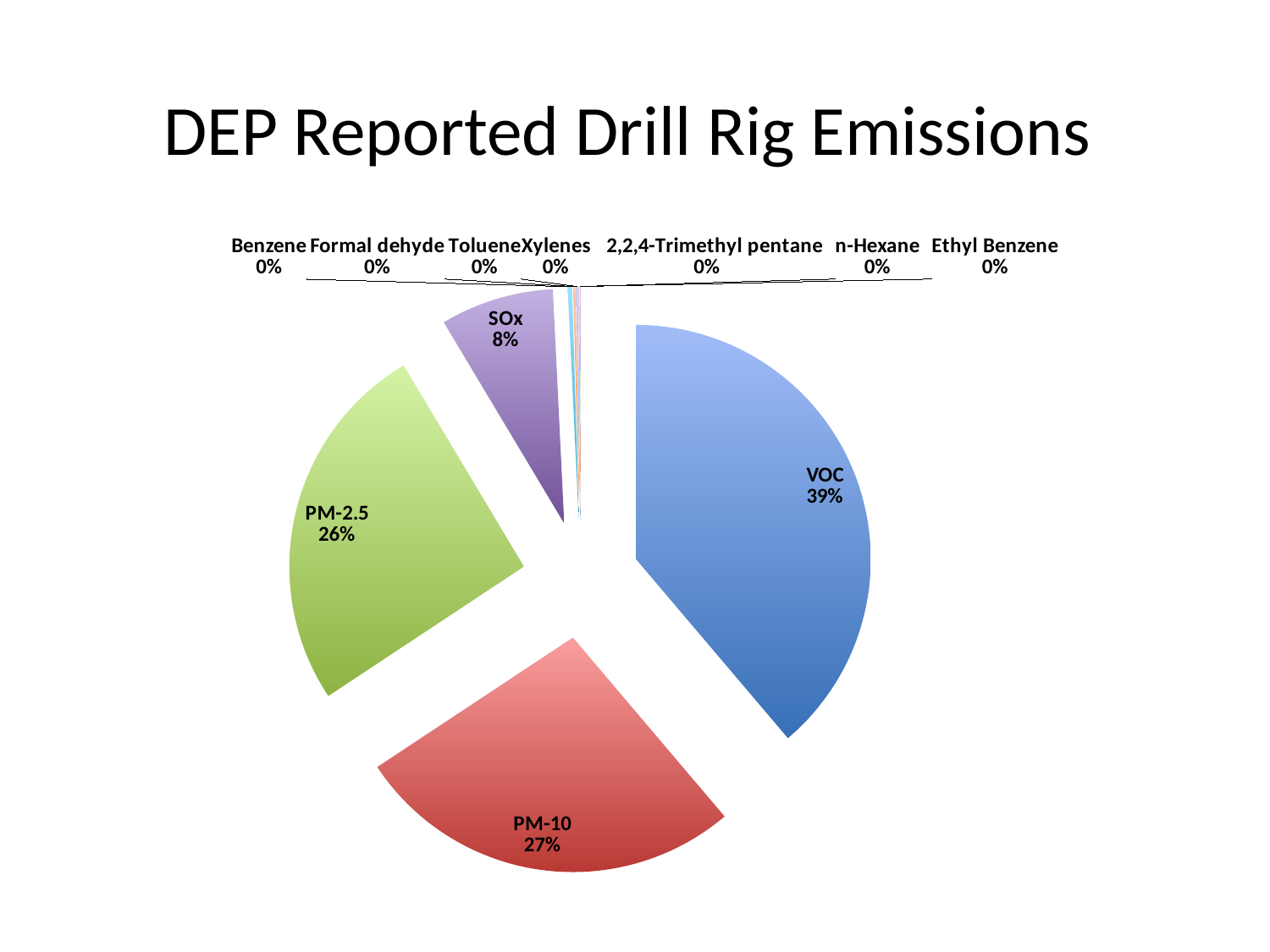
What share of the pie does VOC represent? 39% Which category has the largest slice of the pie? VOC What is the difference in percentage points between PM-10 and SOx? 19% What percentage is shown for Benzene? 0% What is the title of the chart? DEP Reported Drill Rig Emissions What share of the pie does PM-2.5 represent? 26% Which is larger, the share for PM-10 or the share for SOx? PM-10 How many categories are labelled on the pie chart? 11 What share of the pie does PM-10 represent? 27% What type of chart is shown on the slide? Pie chart What is the difference in percentage points between VOC and PM-10? 12%